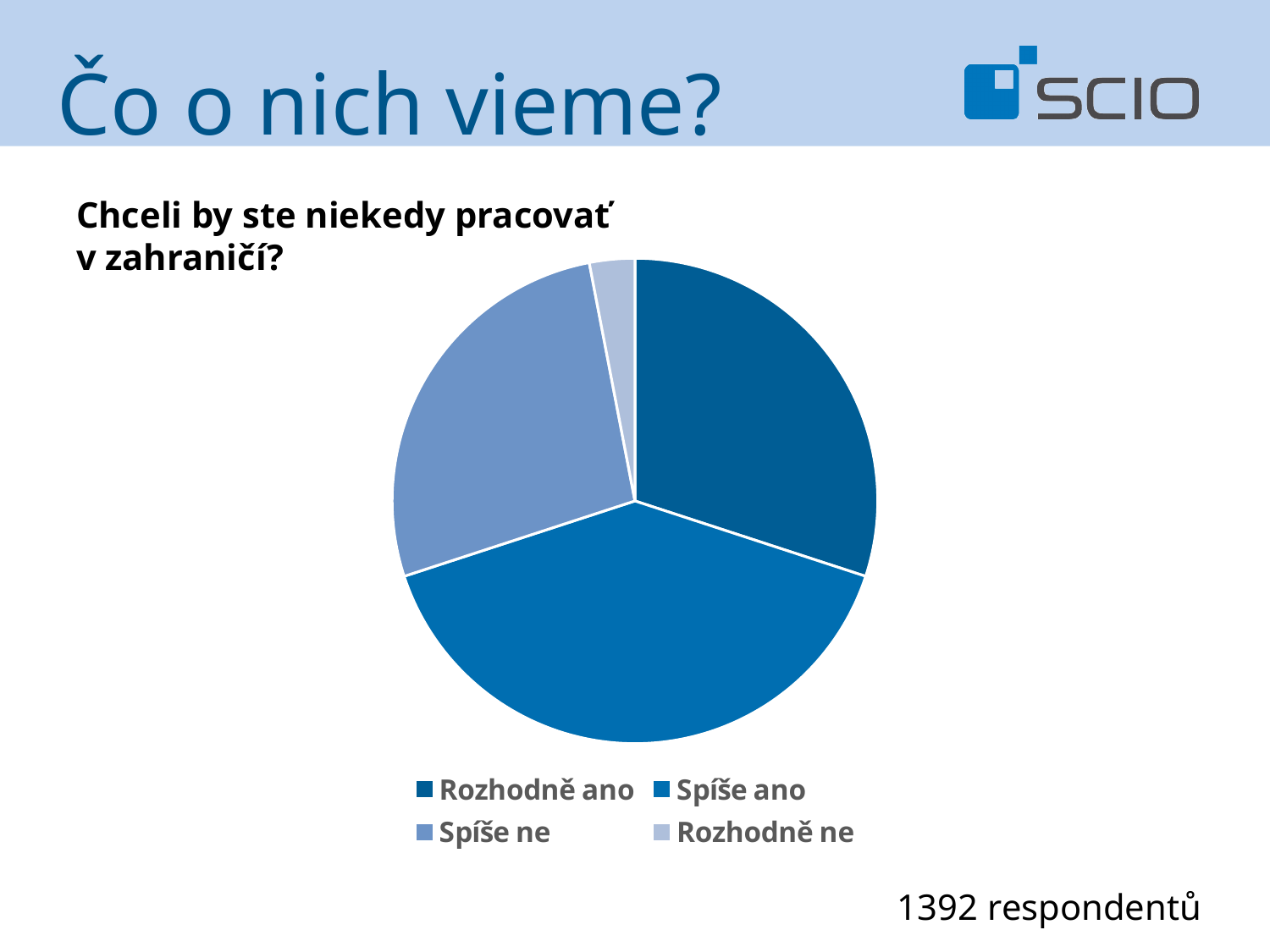
Which answer category has the largest slice of the pie chart? Spíše ano How many slices does the pie chart have? 4 Which slice is larger, Spíše ne or Rozhodně ne? Spíše ne How many entries does the legend of the pie chart list? 4 What kind of chart is shown on the slide? pie chart Which slice is larger, Spíše ano or Rozhodně ne? Spíše ano Which answer category has the smallest slice of the pie chart? Rozhodně ne What survey question does the pie chart present? Chceli by ste niekedy pracovať v zahraničí? Which slice is larger, Spíše ano or Rozhodně ano? Spíše ano Which legend entry is shown in the lightest blue colour? Rozhodně ne